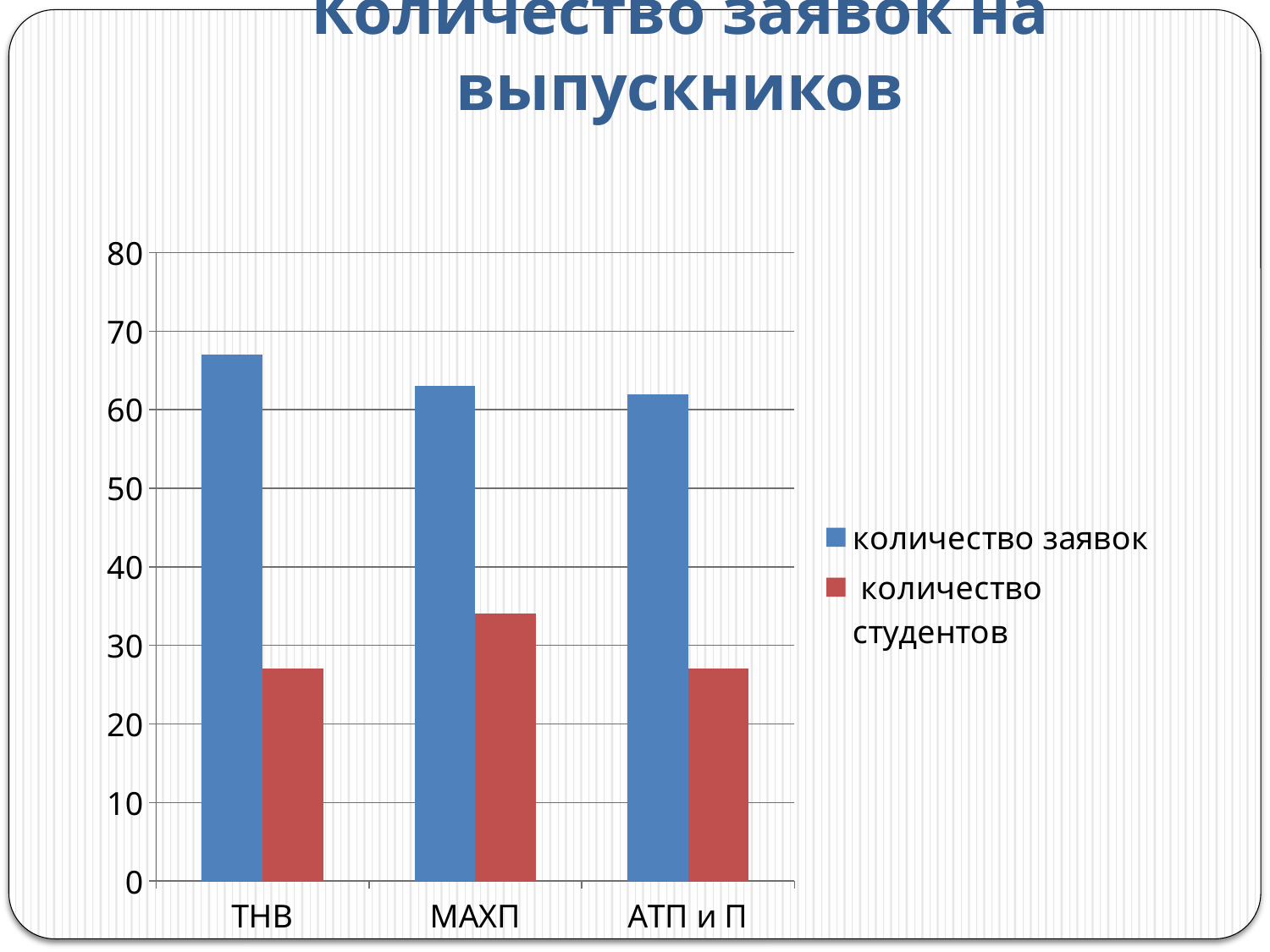
Which is larger for МАХП: количество заявок or количество студентов? количество заявок Which category has the larger value for количество студентов: МАХП or АТП и П? МАХП Which colour represents количество студентов in the chart? red Which category has the highest value for количество студентов? МАХП Is the value of количество студентов for ТНВ greater or less than 30? less Is the value of количество студентов for МАХП greater or less than 30? greater What kind of chart is shown on the slide? bar chart How many series does the legend list? 2 Is the value of количество заявок for АТП и П greater or less than 70? less Which category has the highest value for количество заявок? ТНВ How many categories are shown on the x axis of the chart? 3